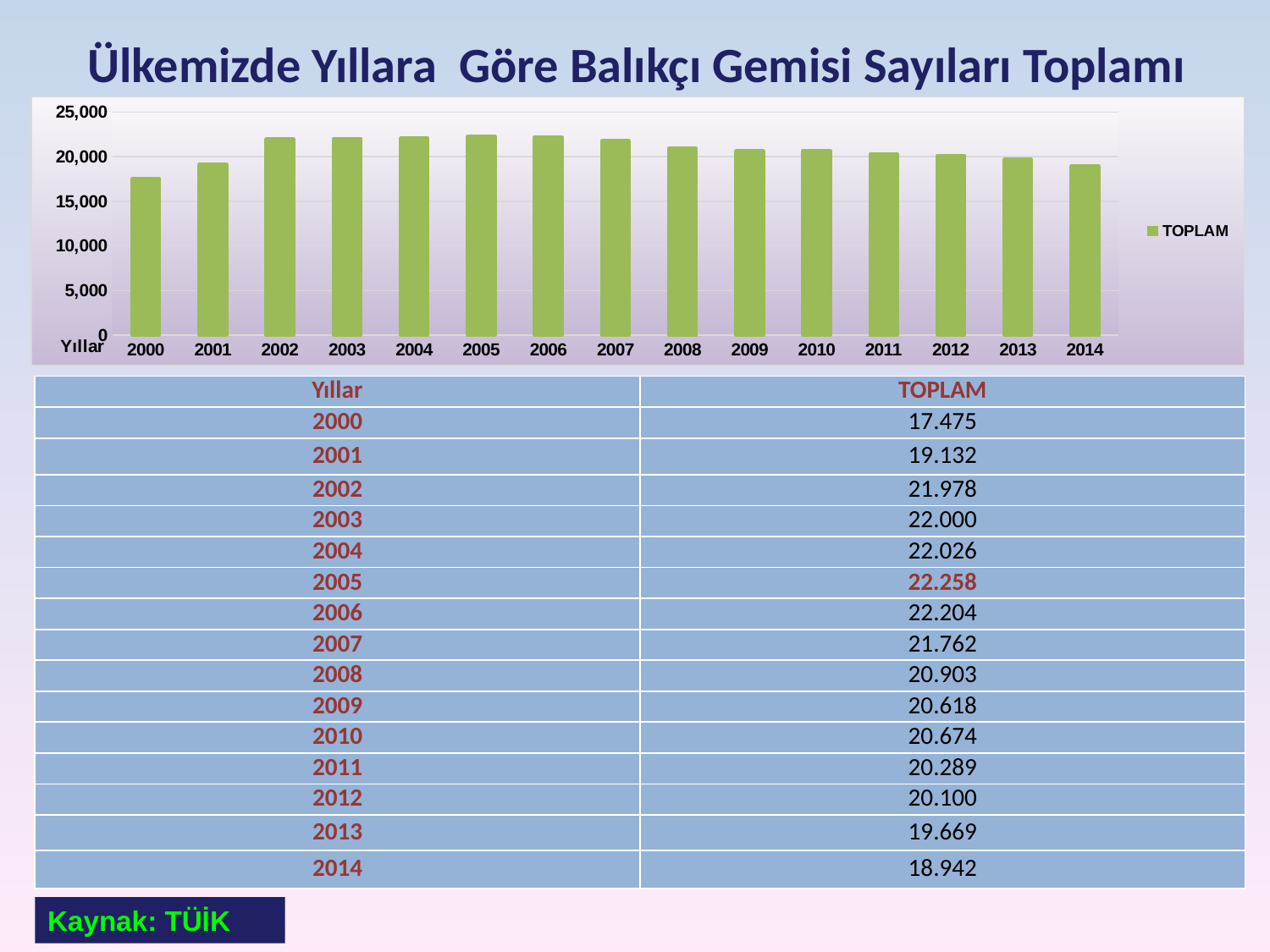
Which year has the lowest TOPLAM value? 2000 What is the difference between the TOPLAM values for 2014 and 2000? 1.467 What is the TOPLAM value for 2008? 20.903 Do the values rise or fall from 2007 to 2014? fall What is the TOPLAM value for 2014? 18.942 Is the value for 2000 greater or less than 20,000? less What is the TOPLAM value for 2000? 17.475 How many years are shown on the x axis of the chart? 15 Which year has the highest TOPLAM value? 2005 What kind of chart is shown on the slide? bar chart Which year has a larger TOPLAM value, 2002 or 2013? 2002 How many series does the chart legend list? 1